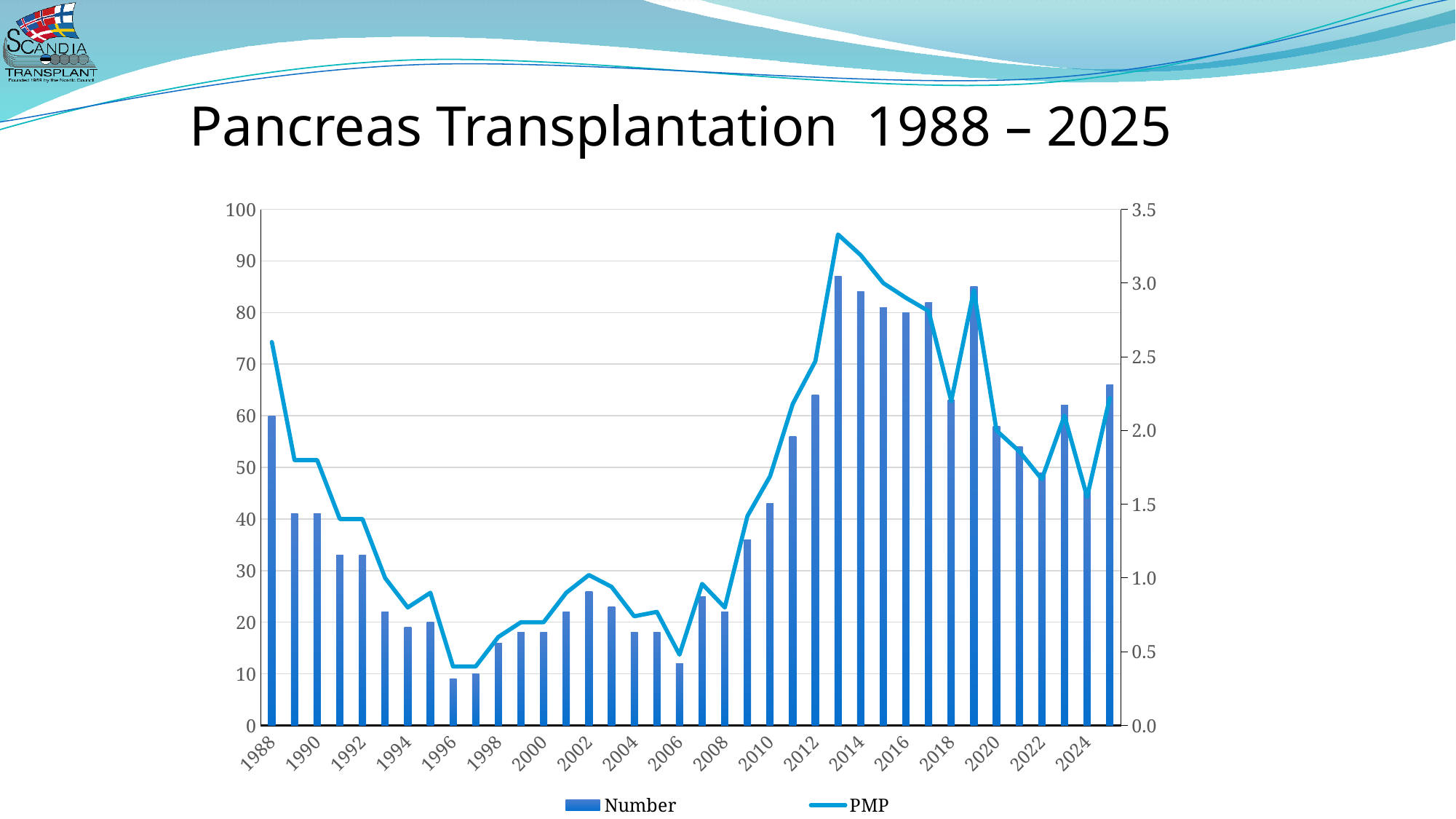
What is the Number value for 1988? 60 Is the Number value for 2013 greater or less than 80? greater What kind of chart is shown on the slide? Combined bar and line chart How many years (bars) are plotted on the chart? 38 In which year is the Number bar highest? 2013 Is the PMP value for 2013 greater or less than 3.0? greater What are the two series named in the legend? Number and PMP How many series does the legend list? 2 Do the Number bars rise or fall from 2013 to 2018? fall Which year has the larger Number value, 1988 or 1990? 1988 Is the Number value for 1996 greater or less than 10? less